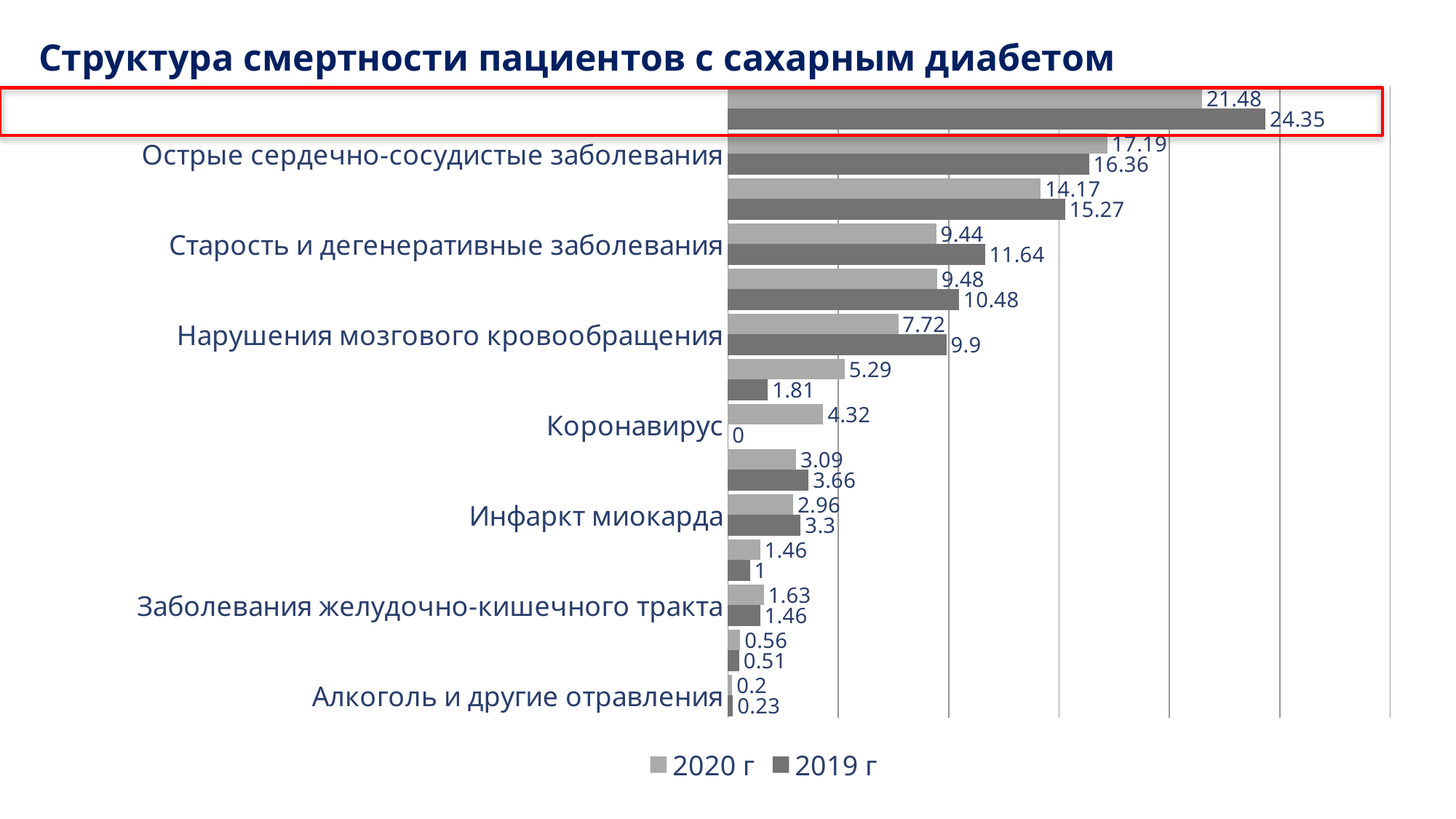
What is the title of the slide? Структура смертности пациентов с сахарным диабетом How many series does the legend list? 2 Which category has the lowest 2019 г value? Коронавирус What kind of chart is shown on the slide? Bar chart What is the difference between the 2020 г and 2019 г values for Острые сердечно-сосудистые заболевания? 0.83 Which is larger for Инфаркт миокарда: the 2020 г value or the 2019 г value? 2019 г What is the value for Острые сердечно-сосудистые заболевания in the 2020 г series? 17.19 What is the highest value shown in the 2020 г series? 21.48 What is the 2020 г value for Нарушения мозгового кровообращения? 7.72 What is the 2019 г value for Коронавирус? 0 What is the value for Старость и дегенеративные заболевания in the 2019 г series? 11.64 What is the difference between the 2019 г and 2020 г values for Старость и дегенеративные заболевания? 2.2